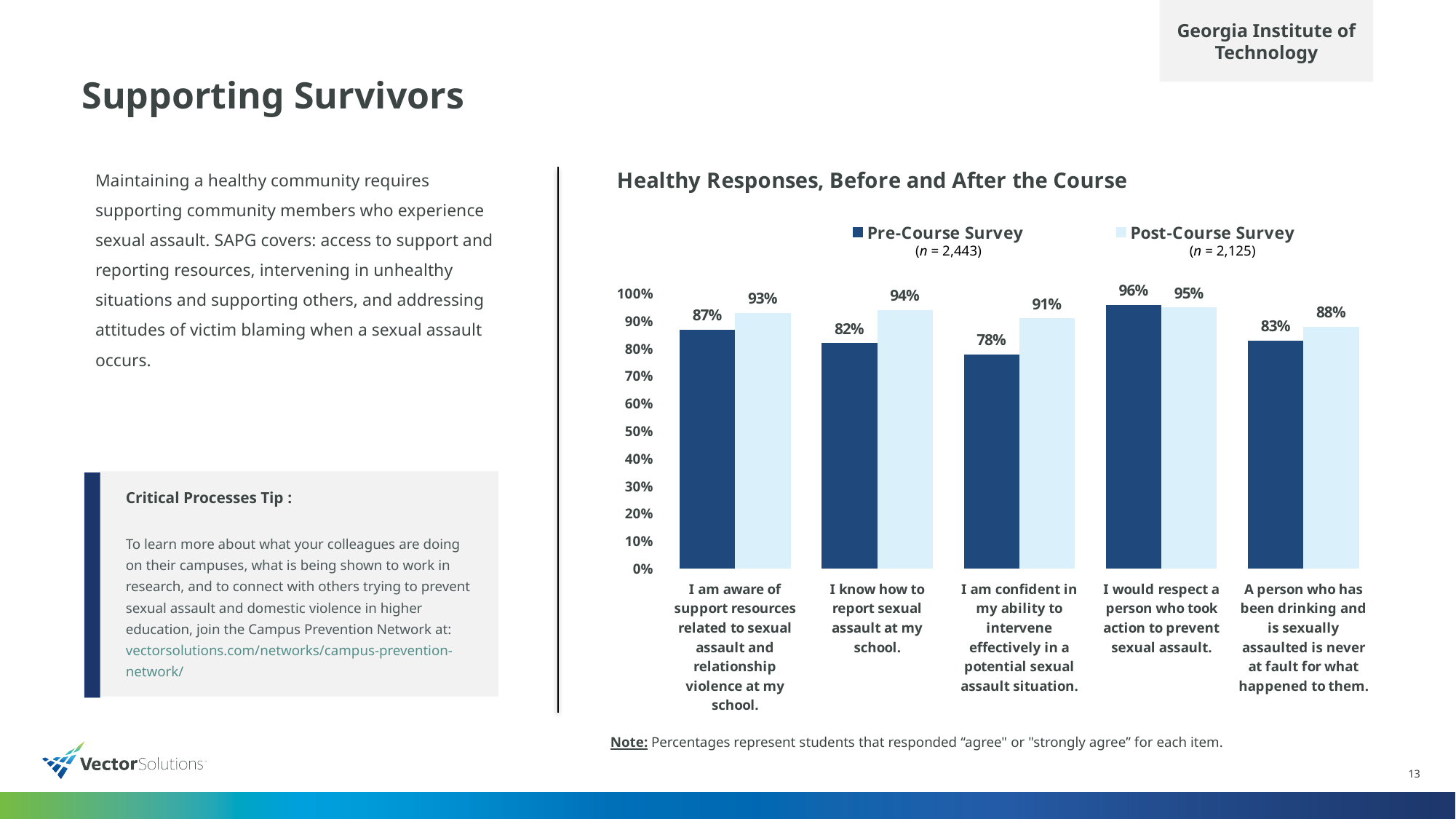
What is the Pre-Course Survey value for "I know how to report sexual assault at my school."? 82% What is the Post-Course Survey value for "I am confident in my ability to intervene effectively in a potential sexual assault situation."? 91% What is the difference between the Post-Course and Pre-Course Survey values for "I am confident in my ability to intervene effectively in a potential sexual assault situation."? 13 percentage points How many items (categories) are shown on the x axis of the chart? 5 What kind of chart is shown on the slide? Bar chart Which item has the highest Pre-Course Survey value? I would respect a person who took action to prevent sexual assault. What is the title of the chart? Healthy Responses, Before and After the Course What is the sample size (n) for the Post-Course Survey shown in the legend? 2,125 Which item has the lowest Pre-Course Survey value? I am confident in my ability to intervene effectively in a potential sexual assault situation. For "I would respect a person who took action to prevent sexual assault.", which is larger: the Pre-Course Survey value or the Post-Course Survey value? Pre-Course Survey What is the Post-Course Survey value for "A person who has been drinking and is sexually assaulted is never at fault for what happened to them."? 88% How many series does the chart legend list? 2